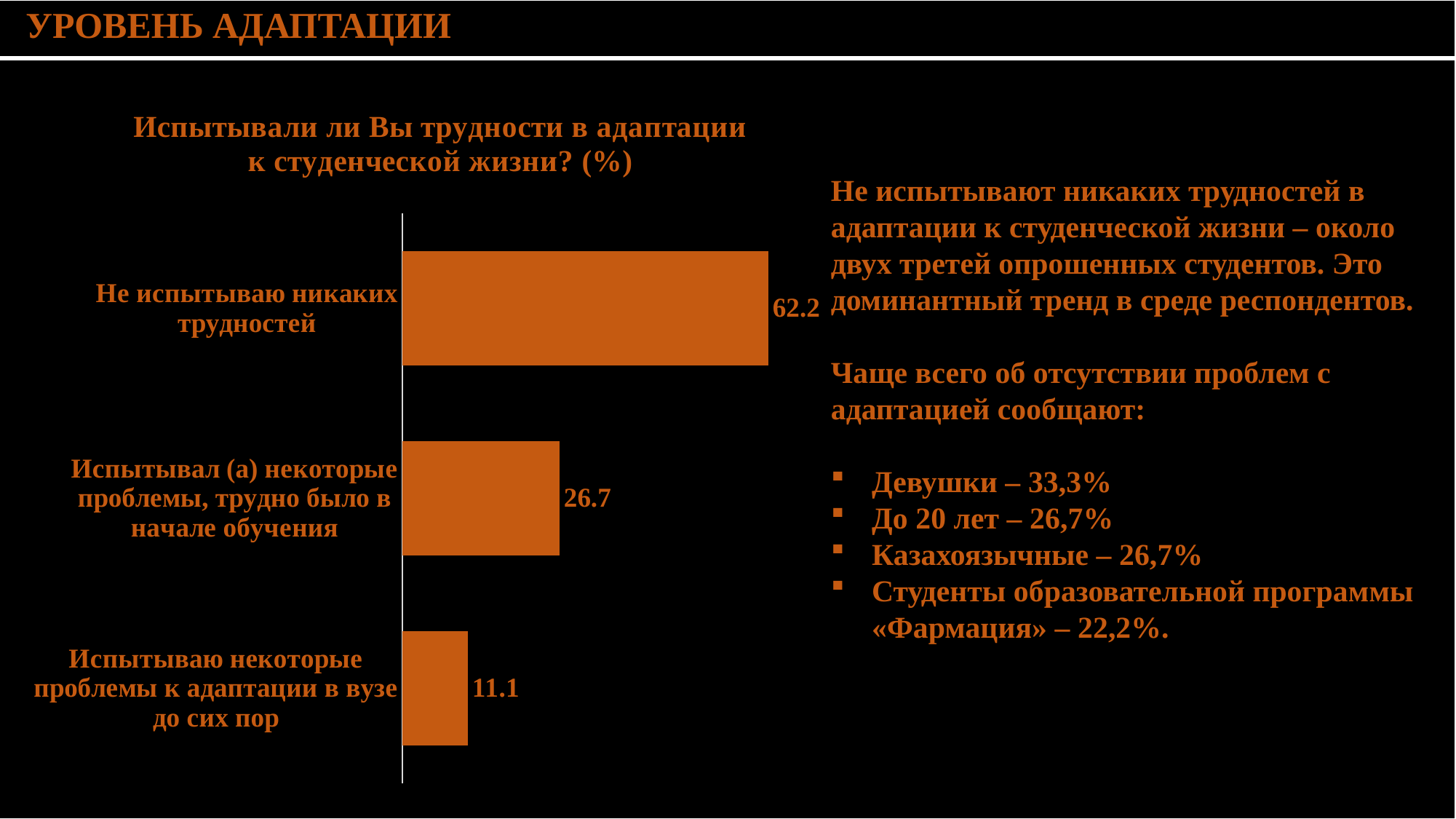
What is the difference between the values for "Не испытываю никаких трудностей" and "Испытывал (а) некоторые проблемы, трудно было в начале обучения"? 35.5 Which category has the highest value? Не испытываю никаких трудностей Which is larger: the value for "Испытывал (а) некоторые проблемы, трудно было в начале обучения" or for "Испытываю некоторые проблемы к адаптации в вузе до сих пор"? Испытывал (а) некоторые проблемы, трудно было в начале обучения What is the difference between the values for "Испытывал (а) некоторые проблемы, трудно было в начале обучения" and "Испытываю некоторые проблемы к адаптации в вузе до сих пор"? 15.6 What is the value for "Испытываю некоторые проблемы к адаптации в вузе до сих пор"? 11.1 How many categories are shown in the chart? 3 What is the value for "Испытывал (а) некоторые проблемы, трудно было в начале обучения"? 26.7 What kind of chart is shown on the slide? Bar chart What colour are the bars in the chart? Orange What is the value for "Не испытываю никаких трудностей"? 62.2 Which category has the lowest value? Испытываю некоторые проблемы к адаптации в вузе до сих пор What is the title of the chart? Испытывали ли Вы трудности в адаптации к студенческой жизни? (%)